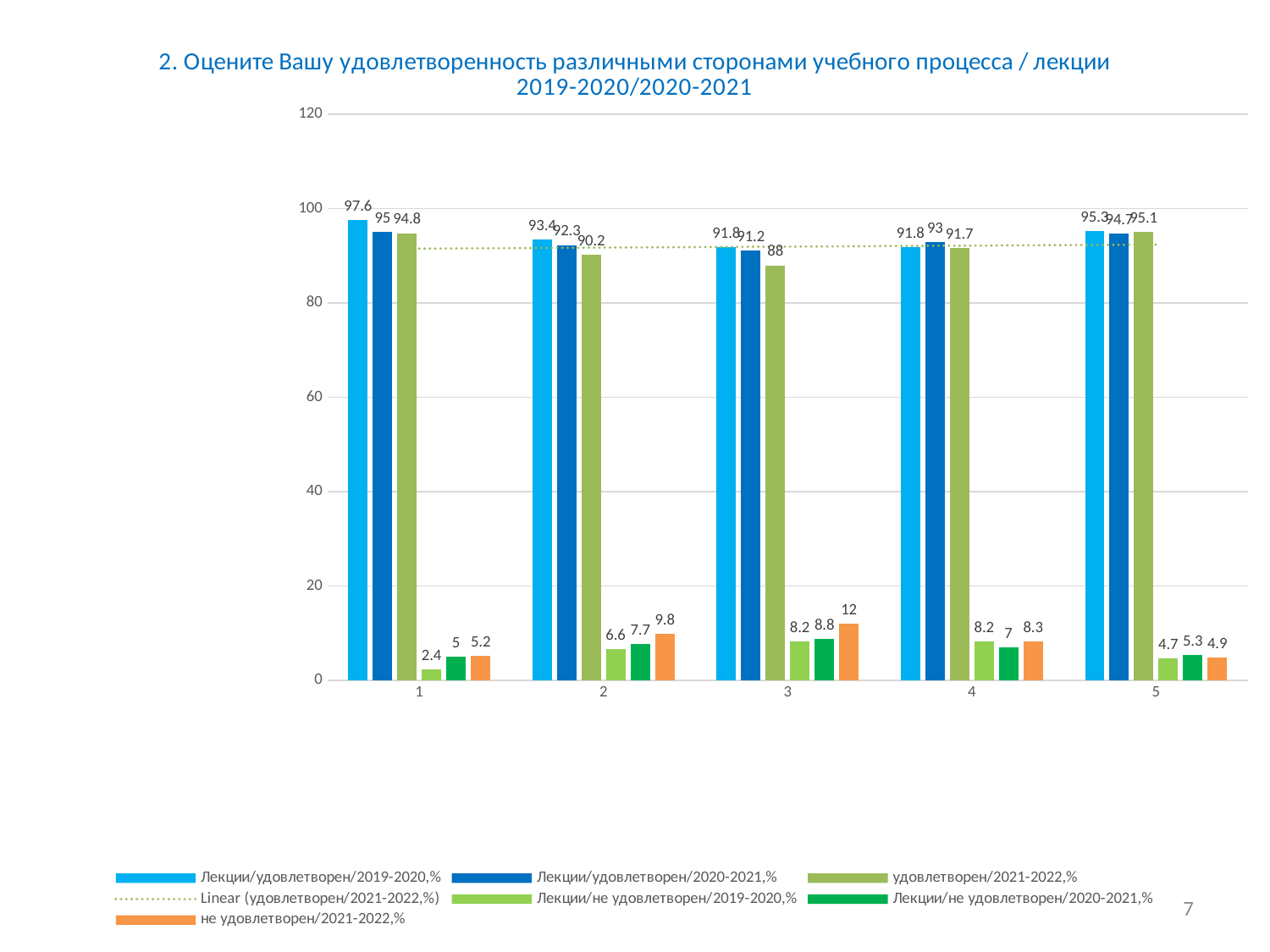
Is the value for Лекции/удовлетворен/2019-2020,% in category 2 greater or less than 80? greater Which category has the lowest value for удовлетворен/2021-2022,%? 3 Which category has the highest value for не удовлетворен/2021-2022,%? 3 How many categories are shown on the x axis? 5 What is the value of не удовлетворен/2021-2022,% for category 3? 12 For category 1, what is the difference between Лекции/удовлетворен/2019-2020,% and удовлетворен/2021-2022,%? 2.8 How many entries does the legend list? 7 What kind of chart is shown on the slide? bar chart For category 4, which is larger: Лекции/удовлетворен/2019-2020,% or Лекции/удовлетворен/2020-2021,%? Лекции/удовлетворен/2020-2021,% What is the value of Лекции/не удовлетворен/2019-2020,% for category 1? 2.4 What is the value of Лекции/удовлетворен/2019-2020,% for category 1? 97.6 Does the value of не удовлетворен/2021-2022,% rise or fall from category 3 to category 5? fall